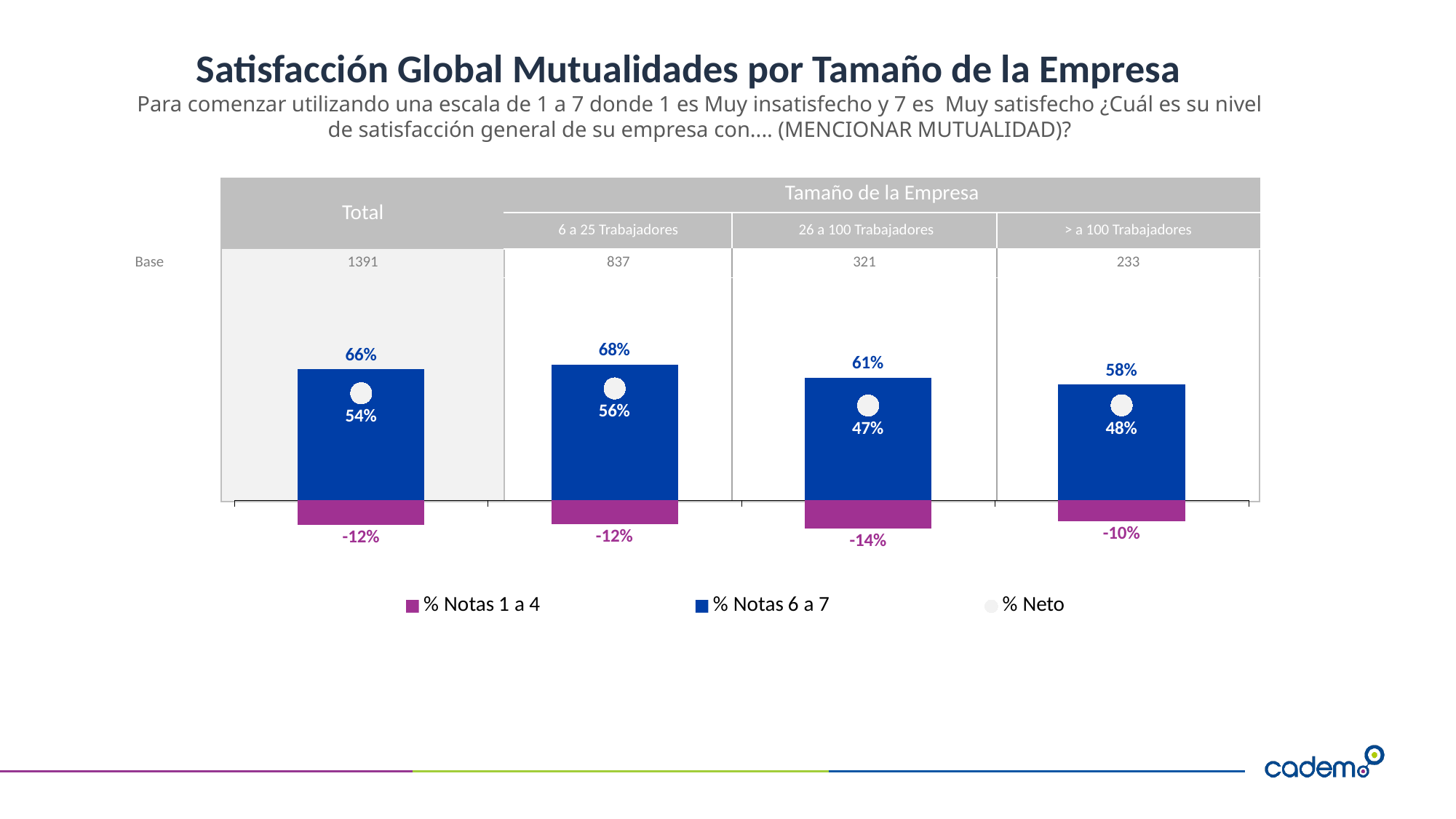
What is the % Notas 1 a 4 value for 26 a 100 Trabajadores? -14% What is the % Notas 6 a 7 value for the Total category? 66% What is the % Neto value for > a 100 Trabajadores? 48% Which category has the highest % Notas 6 a 7 value? 6 a 25 Trabajadores What is the Base (sample size) shown for 26 a 100 Trabajadores? 321 How many series does the legend list? 3 Which category has the lowest % Neto value? 26 a 100 Trabajadores What is the % Neto value for 6 a 25 Trabajadores? 56% Which is larger, the % Neto for Total or the % Neto for 26 a 100 Trabajadores? Total How many categories are shown on the x axis of the chart? 4 What kind of chart is shown on the slide? Combination bar and line chart (bars with % Neto point markers) What is the difference between the % Notas 6 a 7 values for 6 a 25 Trabajadores and > a 100 Trabajadores? 10%